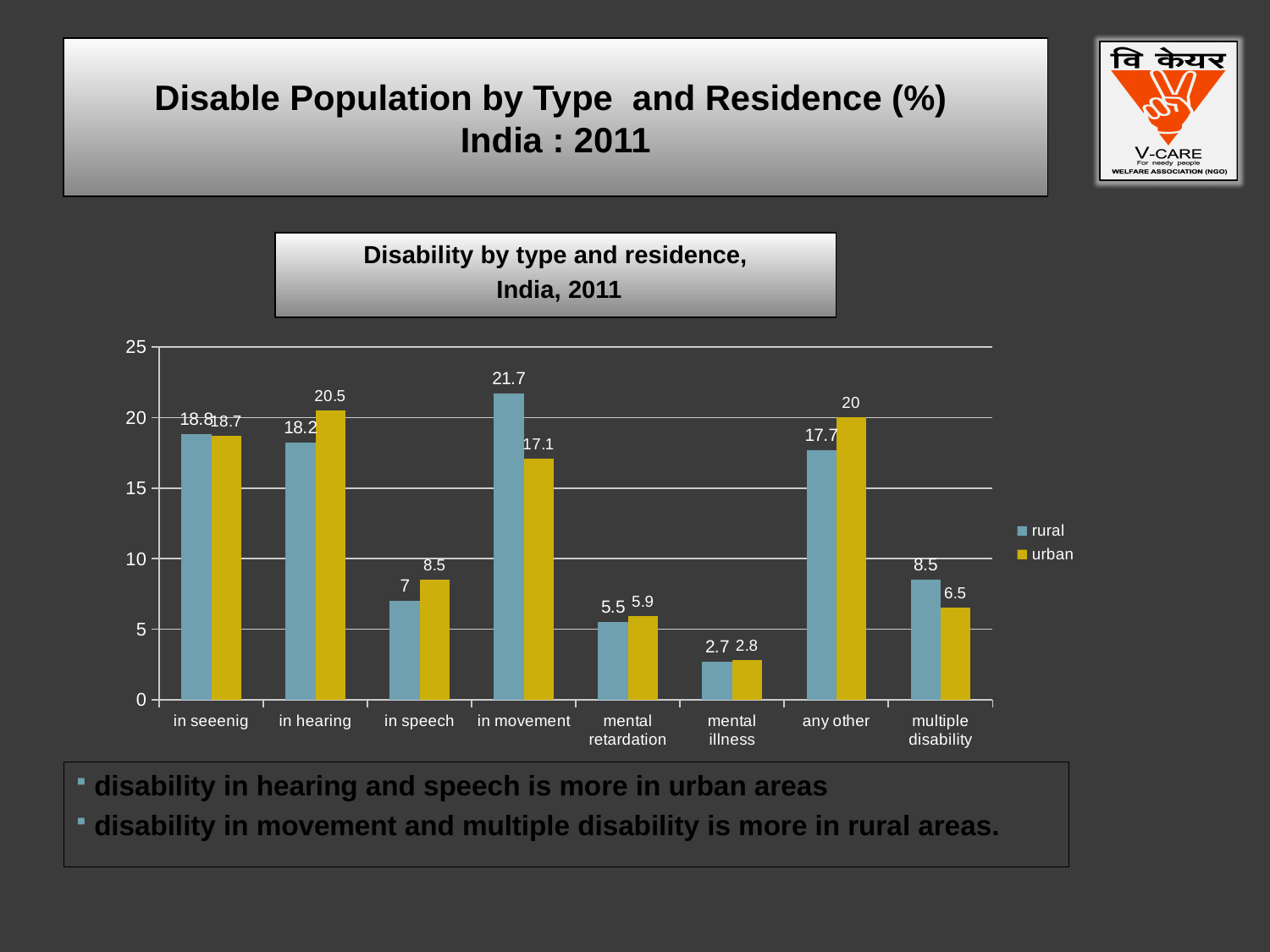
What is the urban value for 'any other'? 20 Which is larger for 'in speech', the rural value or the urban value? urban Which category has the lowest urban value? mental illness What is the urban value for 'in hearing'? 20.5 What kind of chart is shown? bar chart How many series does the legend list? 2 What is the difference between the rural and urban values for 'in movement'? 4.6 How many disability categories are shown on the x axis? 8 What is the rural value for 'multiple disability'? 8.5 Which category has the highest rural value? in movement What is the title of the chart? Disability by type and residence, India, 2011 What is the rural value for 'in movement'? 21.7